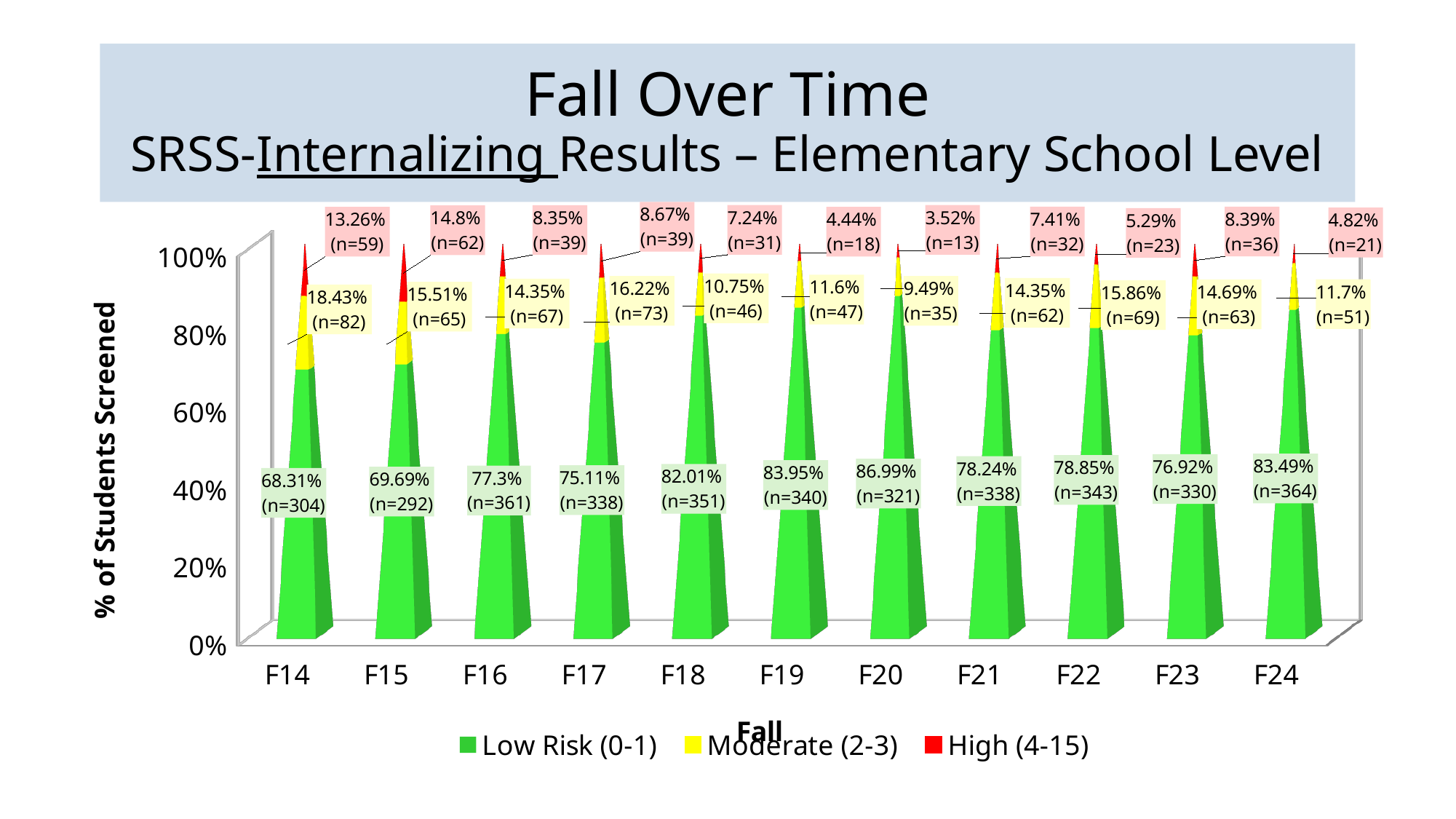
What is the Moderate (2-3) percentage for F17? 16.22% How many series does the legend list? 3 Which fall has the highest Moderate (2-3) percentage? F14 Which fall has the highest Low Risk (0-1) percentage? F20 Which fall has the lowest High (4-15) percentage? F20 What is the difference between the Low Risk (0-1) percentage in F24 and in F14? 15.18% Which is larger, the High (4-15) percentage for F16 or for F23? F23 What is the High (4-15) percentage for F15? 14.8% What kind of chart is shown on the slide? Stacked bar chart How many students were in the Low Risk (0-1) group in F24? n=364 What is the Low Risk (0-1) percentage for F20? 86.99% How many fall periods are shown on the x axis? 11